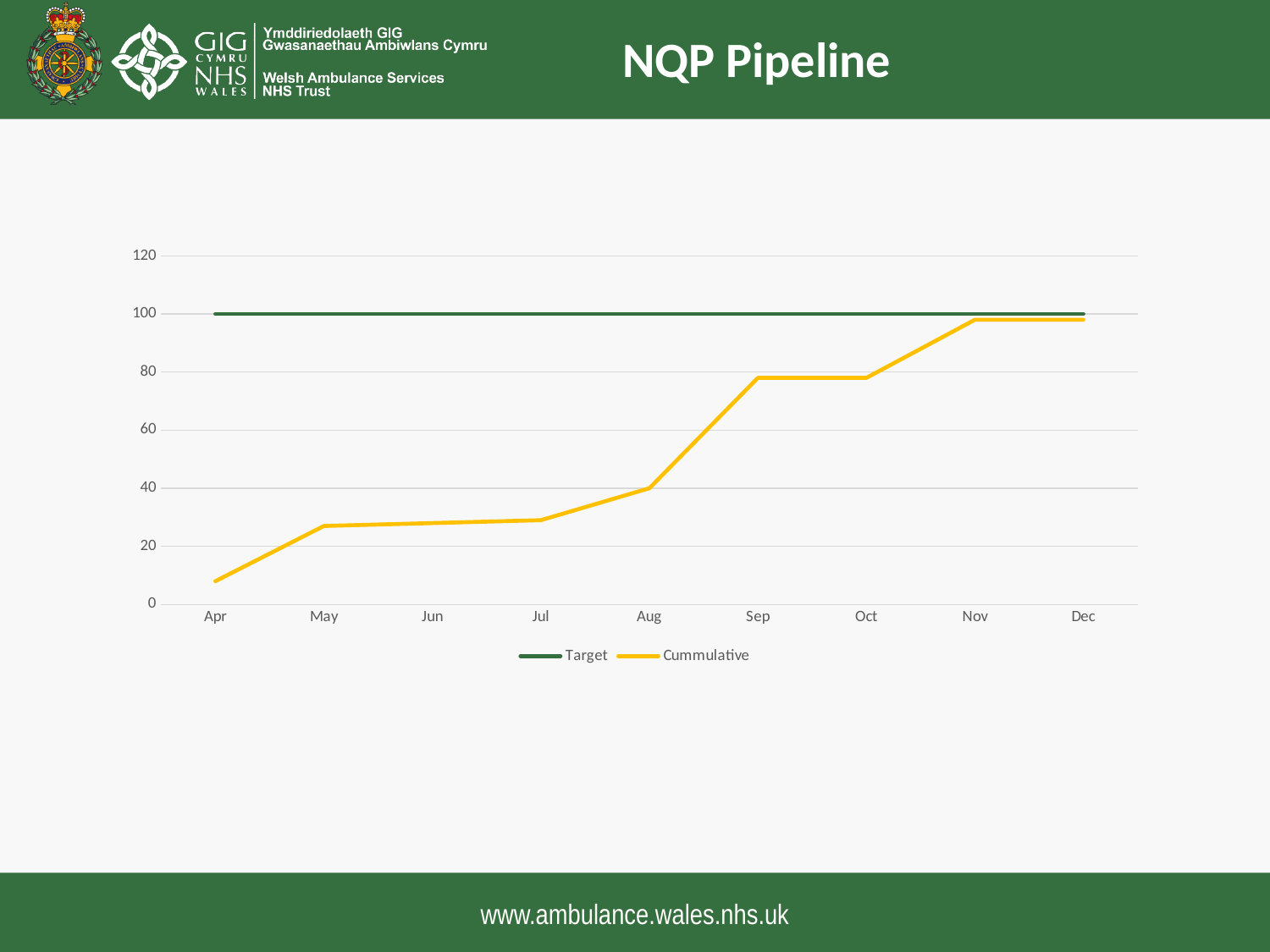
Is the Cummulative value for Dec greater or less than 100? less In which month is the Cummulative value lowest? Apr What is the value of the Target series across the months? 100 Is the Cummulative value for Apr greater or less than 20? less What kind of chart is shown on the slide? line chart In Dec, which is larger: the Target value or the Cummulative value? Target How many months are shown on the x axis? 9 Does the Cummulative series rise or fall from Apr to Dec? rise Is the Cummulative value for May greater or less than 20? greater How many series does the legend list? 2 What is the title of the slide containing the chart? NQP Pipeline